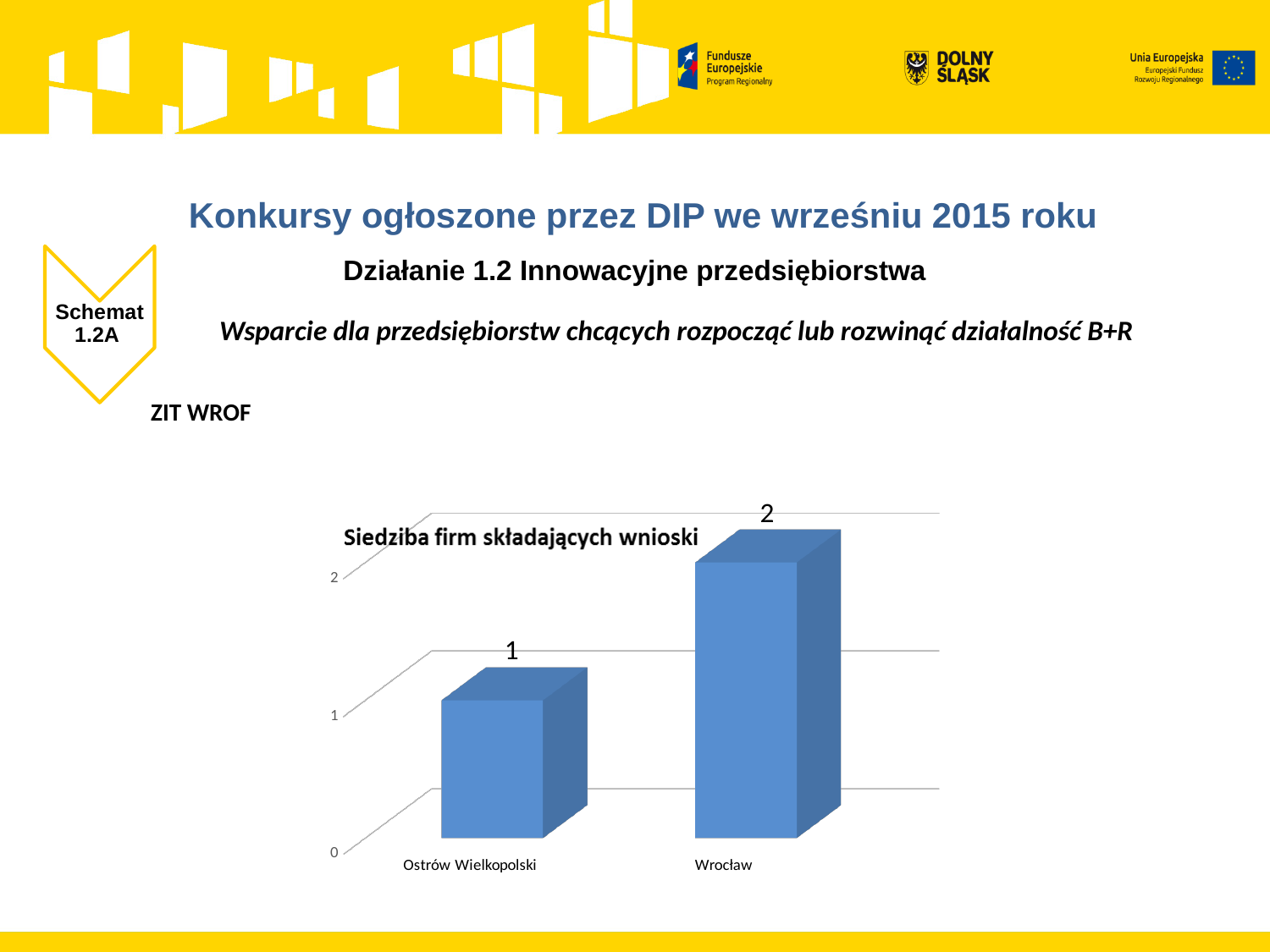
What colour are the bars in the chart? blue What is the value for Ostrów Wielkopolski? 1 What is the value for Wrocław? 2 What is the difference between the values for Wrocław and Ostrów Wielkopolski? 1 What kind of chart is shown on the slide? bar chart How many categories are shown in the chart? 2 What is the total of the values for Ostrów Wielkopolski and Wrocław? 3 Which is larger, the value for Wrocław or the value for Ostrów Wielkopolski? Wrocław Which category has the lowest value? Ostrów Wielkopolski Do the values rise or fall from Ostrów Wielkopolski to Wrocław? rise Which category has the highest value? Wrocław What is the title of the chart? Siedziba firm składających wnioski